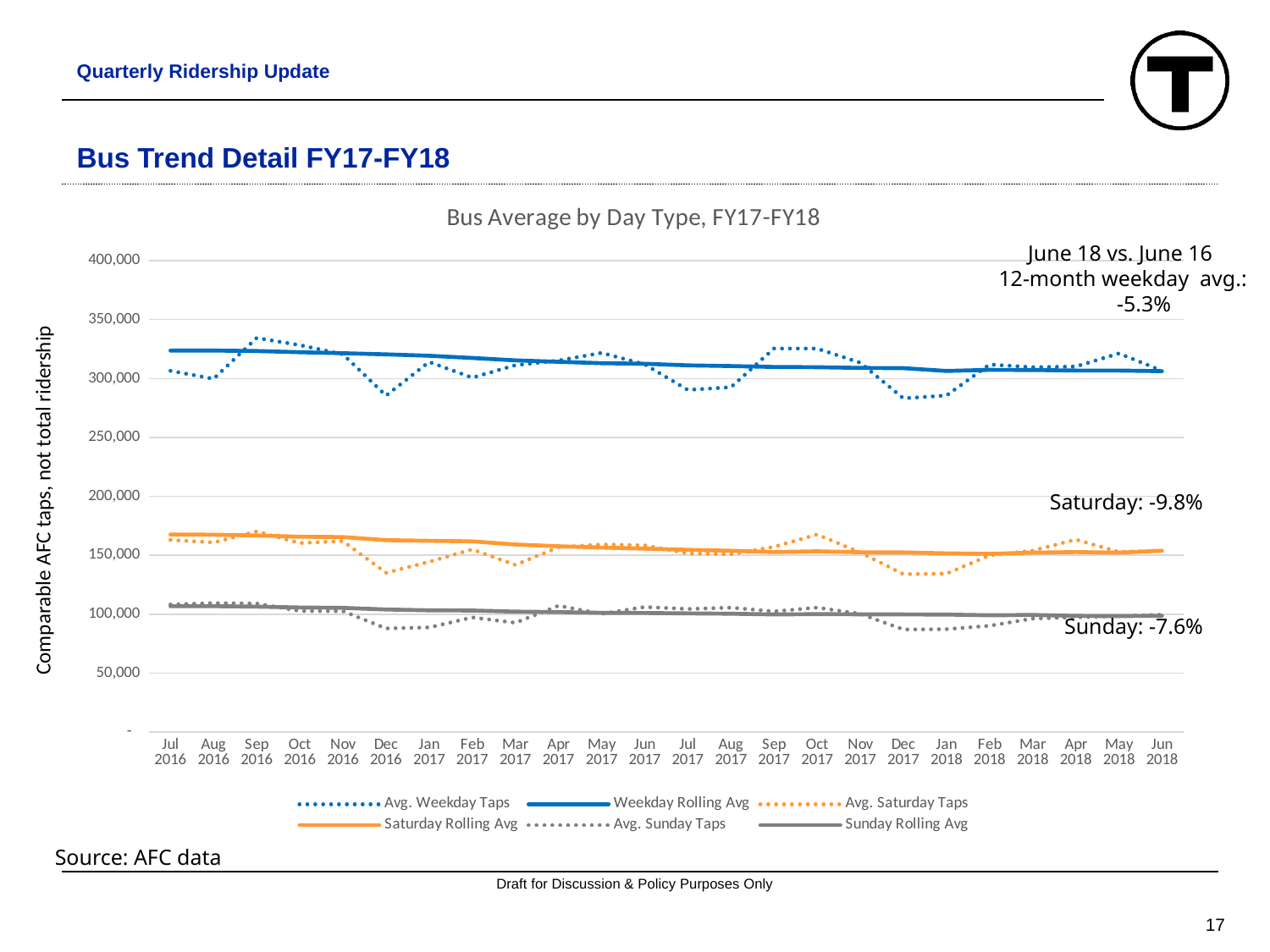
Which is larger in Jun 2018, the Weekday Rolling Avg or the Saturday Rolling Avg? Weekday Rolling Avg How many series does the legend list? 6 According to the annotation, what is the change for Saturday, June 18 vs. June 16? -9.8% Does the Weekday Rolling Avg line rise or fall from Jul 2016 to Jun 2018? Fall How many months are plotted along the x axis? 24 What kind of chart is shown on the slide? Line chart According to the annotation, what is the change for Sunday, June 18 vs. June 16? -7.6% Is the value for Sunday Rolling Avg in Jul 2016 greater or less than 150,000? less According to the annotation, what is the change in the 12-month weekday average for June 18 vs. June 16? -5.3% Is the value for Avg. Saturday Taps in Dec 2016 greater or less than 150,000? less Is the value for Avg. Weekday Taps in Dec 2016 greater or less than 300,000? less What is the title of the chart? Bus Average by Day Type, FY17-FY18